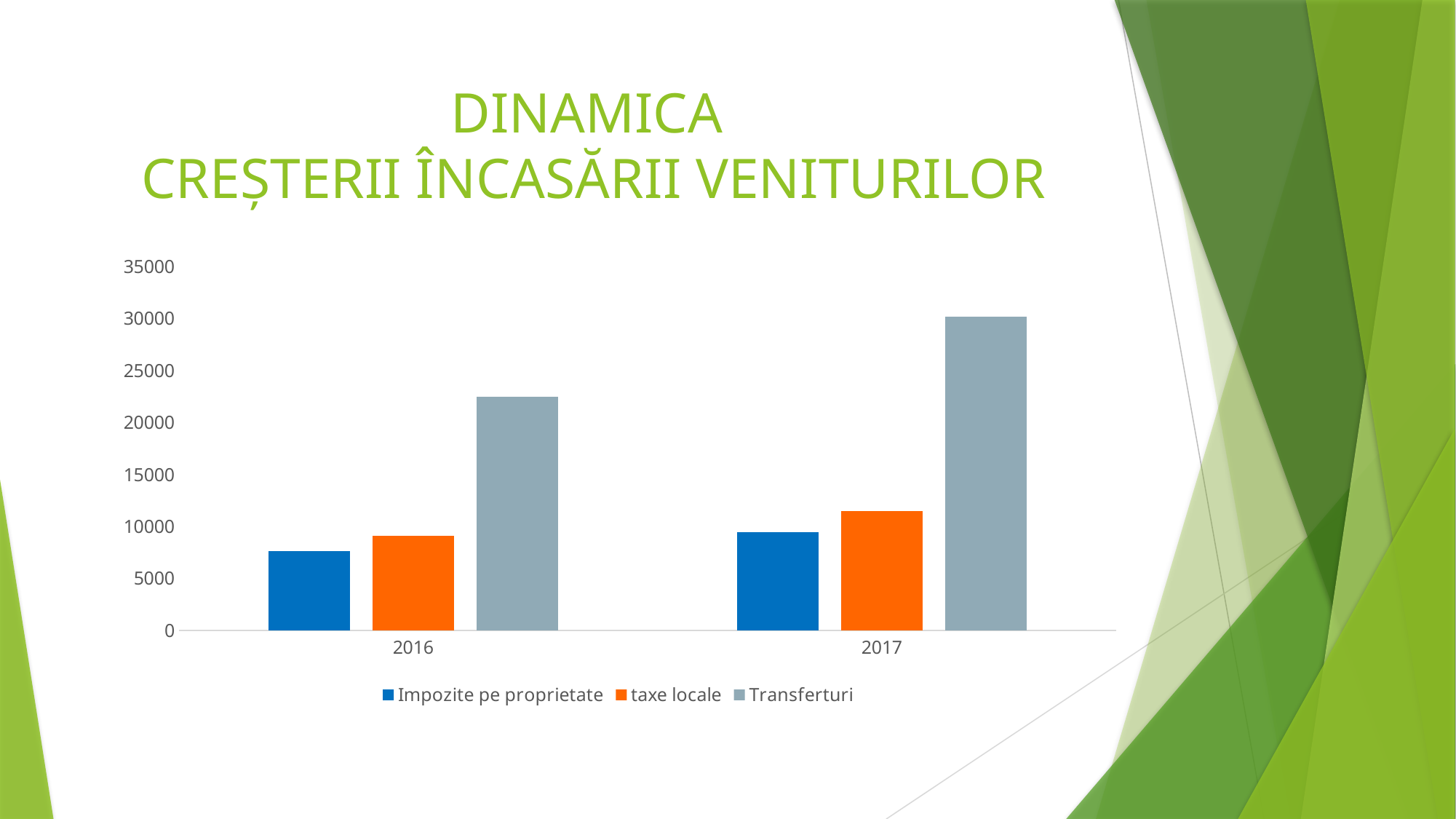
What kind of chart is shown on the slide? bar chart Is the value for Transferturi in 2017 greater or less than 25000? greater How many years are shown on the x axis? 2 Is the value for Impozite pe proprietate in 2016 greater or less than 10000? less Which series has the lowest value in 2016? Impozite pe proprietate Which is larger in 2016: taxe locale or Impozite pe proprietate? taxe locale Is the value for Transferturi in 2016 greater or less than 20000? greater Which series is shown in orange? taxe locale What is the title of the slide? DINAMICA CREȘTERII ÎNCASĂRII VENITURILOR Which series has the highest value in 2017? Transferturi Does the value for Transferturi rise or fall from 2016 to 2017? rise How many series does the legend list? 3